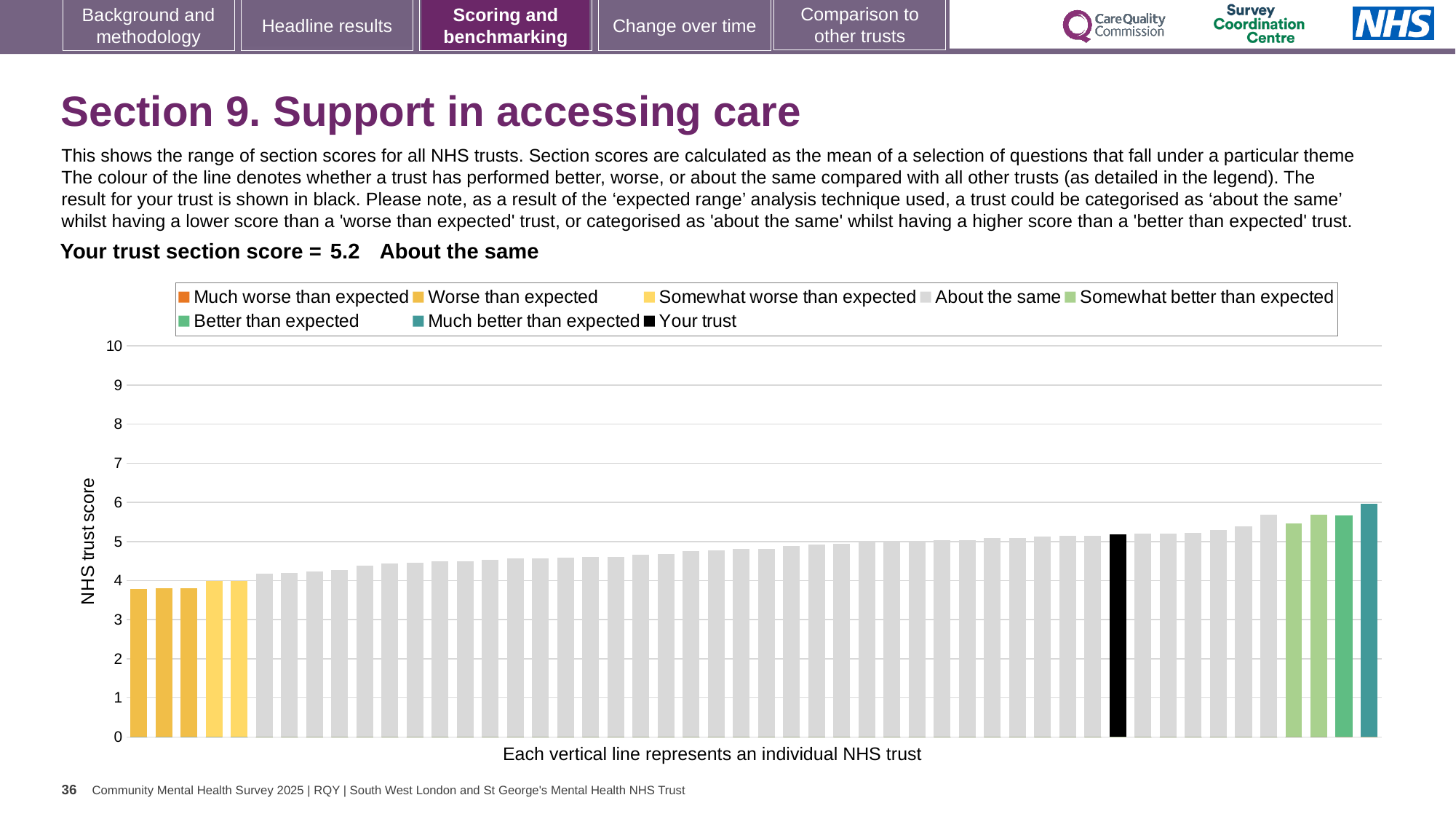
What colour is the bar representing your trust? black What is the label on the vertical axis of the chart? NHS trust score What is the section score for your trust? 5.2 Do the bar values rise or fall from left to right along the x axis? rise Is the value of the lowest bar greater or less than 4? less Which legend category do the lowest bars belong to? Worse than expected How many bars are coloured as 'Much better than expected'? 1 Is the value for your trust (the black bar) greater or less than 6? less Which legend category does the highest bar belong to? Much better than expected How many entries does the chart legend list? 8 Is the value for your trust (the black bar) greater or less than 5? greater What kind of chart is shown on the slide? bar chart